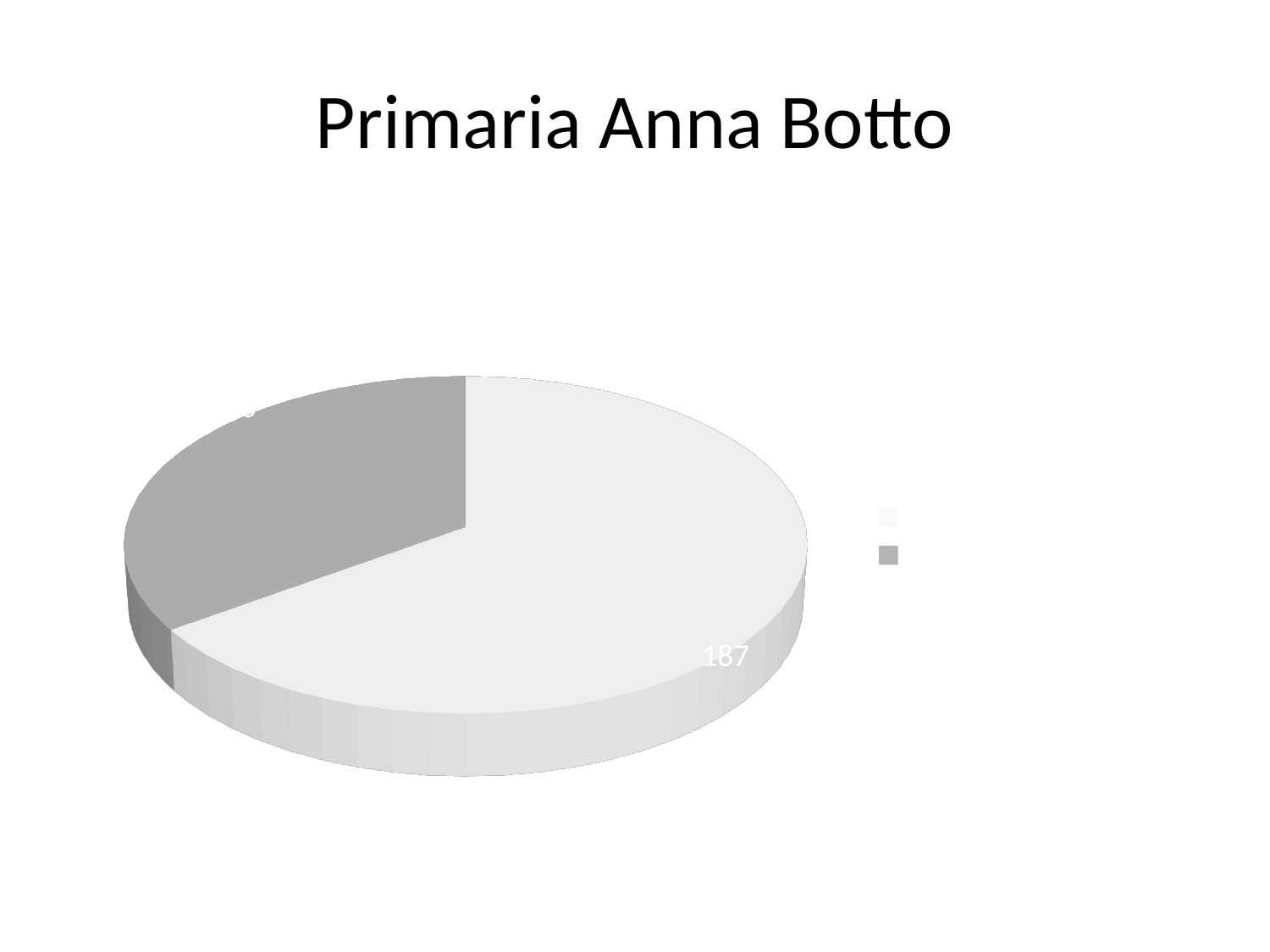
Is the value of the light grey slice greater or less than 100? greater How many slices does the pie chart have? 2 What kind of chart is shown on the slide? pie chart What value is printed on the largest slice of the pie? 187 What colour is the largest slice of the pie? light grey What value is printed on the light grey slice of the pie? 187 Which slice is larger, the light grey slice or the dark grey slice? the light grey slice How many entries does the legend list? 2